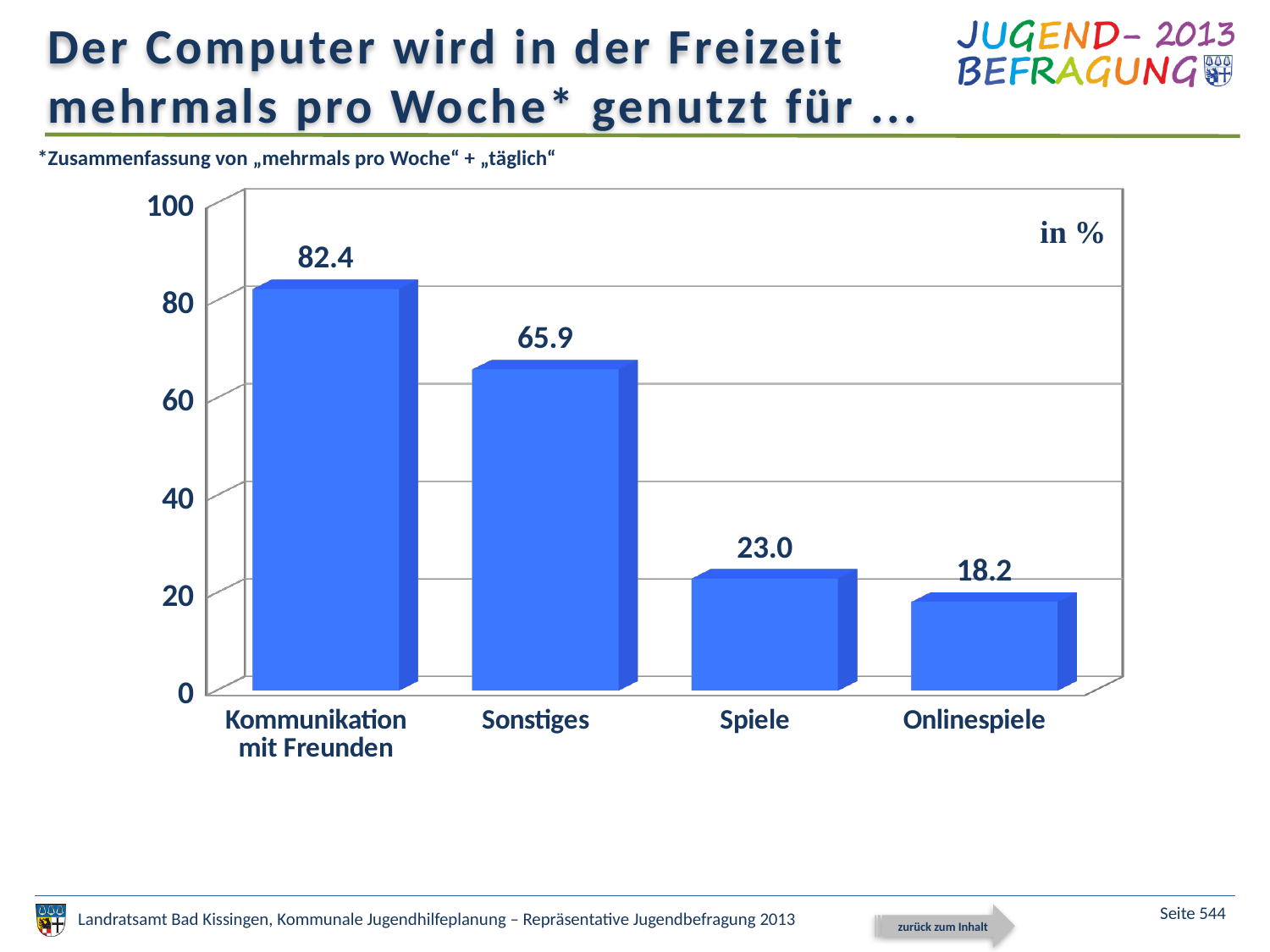
How many categories are shown in the chart? 4 What is the value for Kommunikation mit Freunden? 82.4 Which category has the lowest value? Onlinespiele What is the difference between the values for Kommunikation mit Freunden and Sonstiges? 16.5 What is the difference between the values for Spiele and Onlinespiele? 4.8 What is the value for Onlinespiele? 18.2 Which is larger, the value for Sonstiges or the value for Spiele? Sonstiges What is the value for Sonstiges? 65.9 What kind of chart is shown on the slide? Bar chart What unit is indicated in the top right corner of the chart? in % What is the value for Spiele? 23.0 Which category has the highest value? Kommunikation mit Freunden